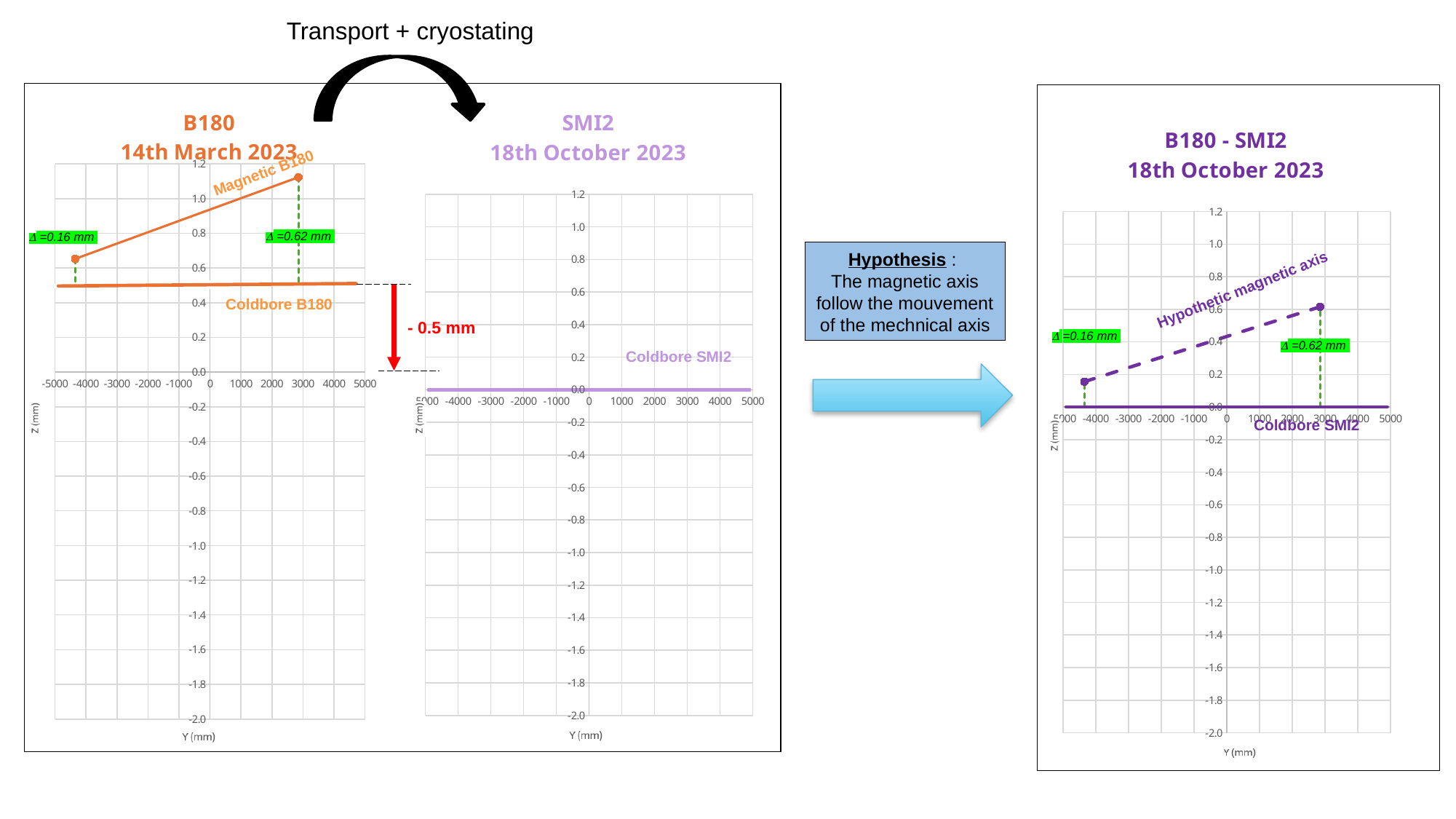
What vertical shift is annotated between the B180 14th March 2023 chart and the SMI2 18th October 2023 chart? - 0.5 mm In the B180 14th March 2023 chart, what is the vertical axis label? Z (mm) In the B180 14th March 2023 chart, is the Z value of the right endpoint of the Magnetic B180 line greater or less than 1.0? greater In the B180 14th March 2023 chart, what Δ value is annotated at the left end of the Magnetic B180 line? 0.16 mm In the B180 14th March 2023 chart, what Δ value is annotated at the right end of the Magnetic B180 line? 0.62 mm What kind of chart is the B180 14th March 2023 chart? line chart In the B180 14th March 2023 chart, is the Z value of the Coldbore B180 line greater or less than 0.4? greater In the SMI2 18th October 2023 chart, at what Z value does the Coldbore SMI2 line lie? 0.0 In the B180 - SMI2 18th October 2023 chart, what is the horizontal axis label? Y (mm) In the B180 14th March 2023 chart, which line is higher, Magnetic B180 or Coldbore B180? Magnetic B180 In the B180 14th March 2023 chart, does the Magnetic B180 line rise or fall as Y increases? rise